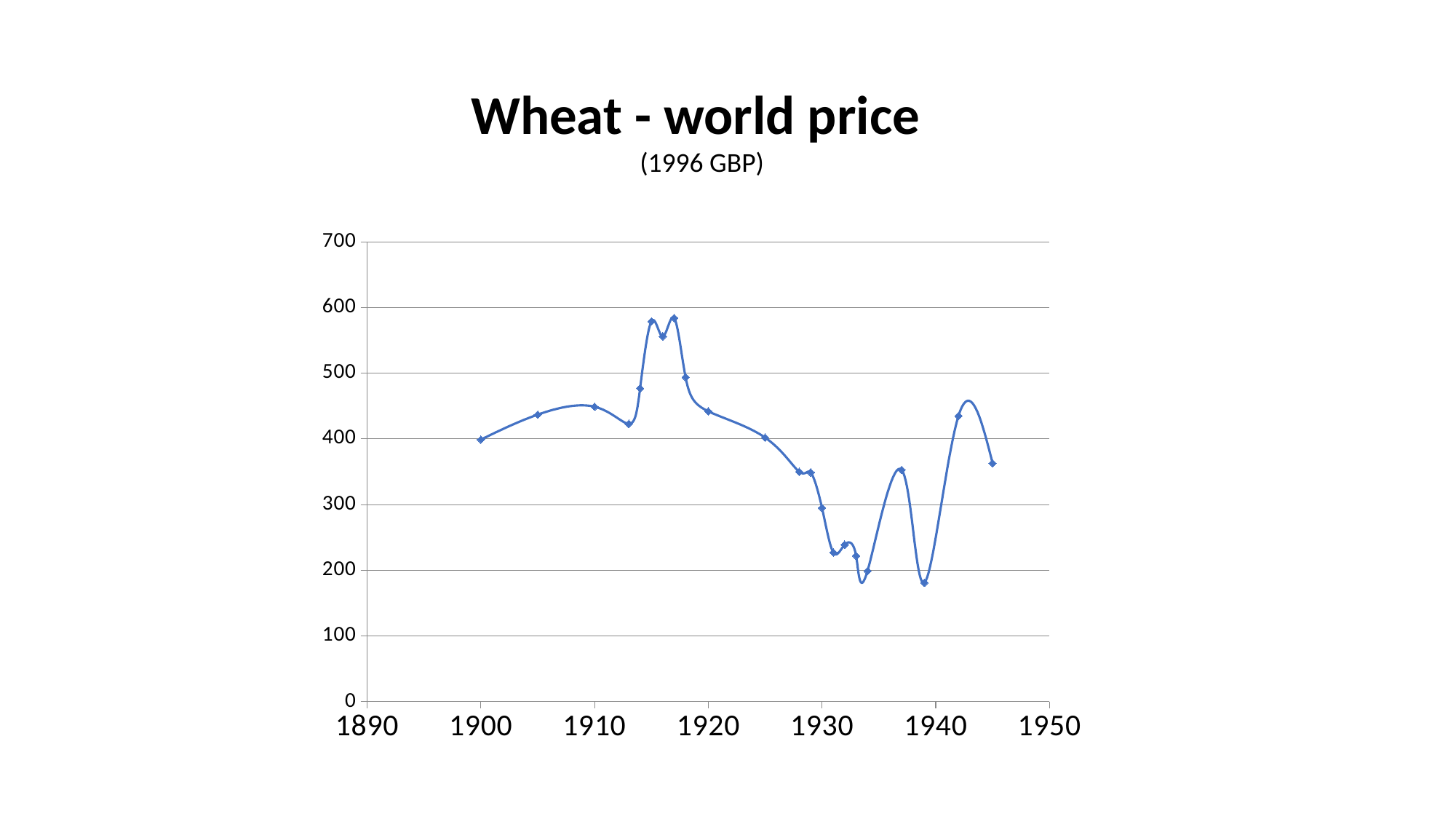
Does the wheat price rise or fall between 1925 and 1934? fall Is the value for 1931 greater or less than 300? less Is the value for 1937 greater or less than 300? greater Is the value for 1945 greater or less than 400? less In what units is the wheat price expressed, according to the subtitle? 1996 GBP Which is larger, the value for 1917 or the value for 1939? 1917 Which is larger, the value for 1942 or the value for 1945? 1942 What is the title of the chart? Wheat - world price What kind of chart is shown on the slide? line chart